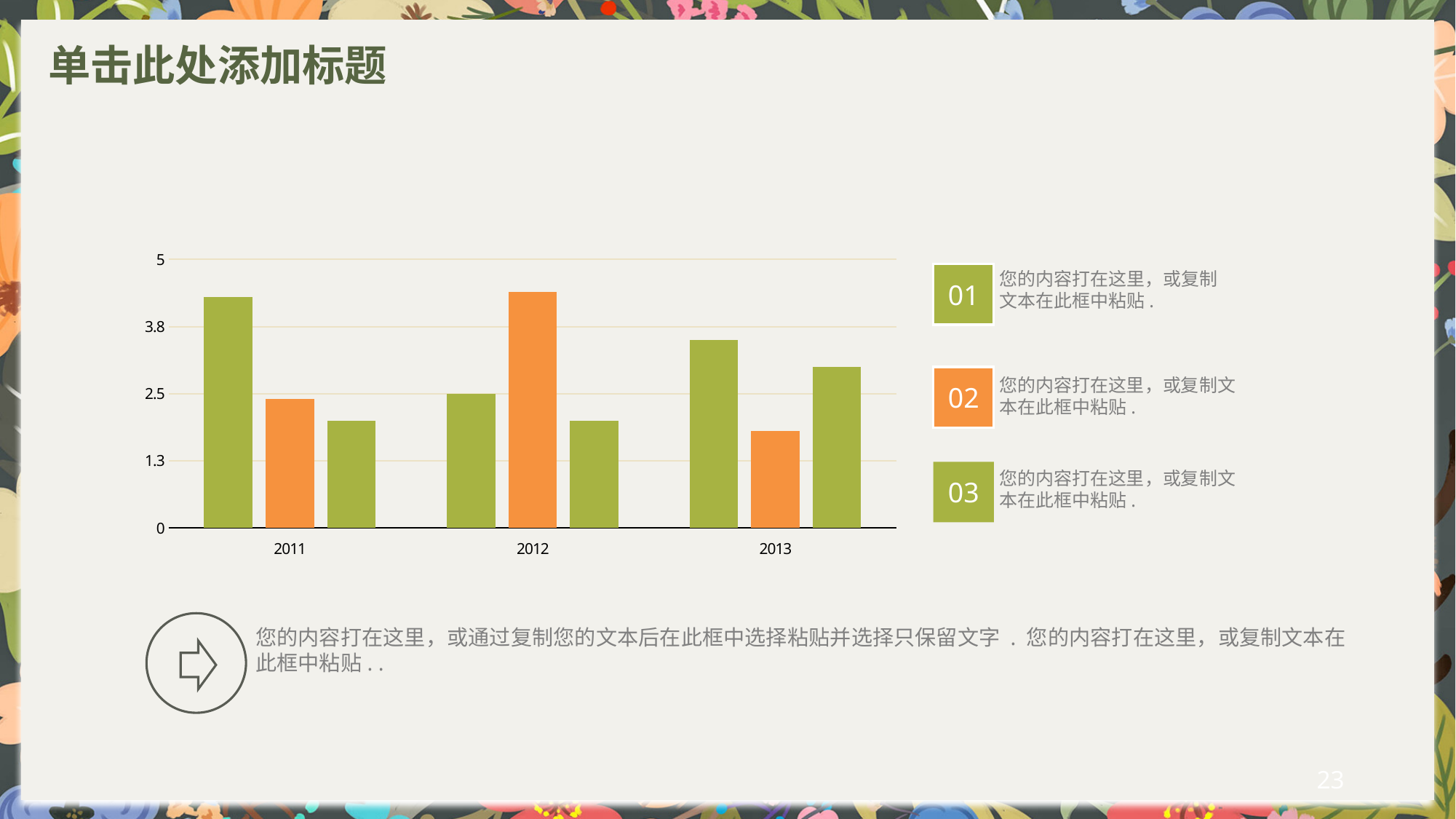
How many categories are shown on the x axis of the chart? 3 What is the highest value shown on the chart's y axis? 5 Is the value of the orange bar for 2012 greater or less than 3.8? greater Which year has the tallest orange bar? 2012 Is the value of the third (green) bar for 2012 greater or less than 2.5? less Is the value of the orange bar for 2013 greater or less than 1.3? greater What kind of chart is shown on the slide? bar chart Which is larger: the orange bar for 2011 or the orange bar for 2013? 2011 How many bars are plotted for each year in the chart? 3 Which year has the shortest orange bar? 2013